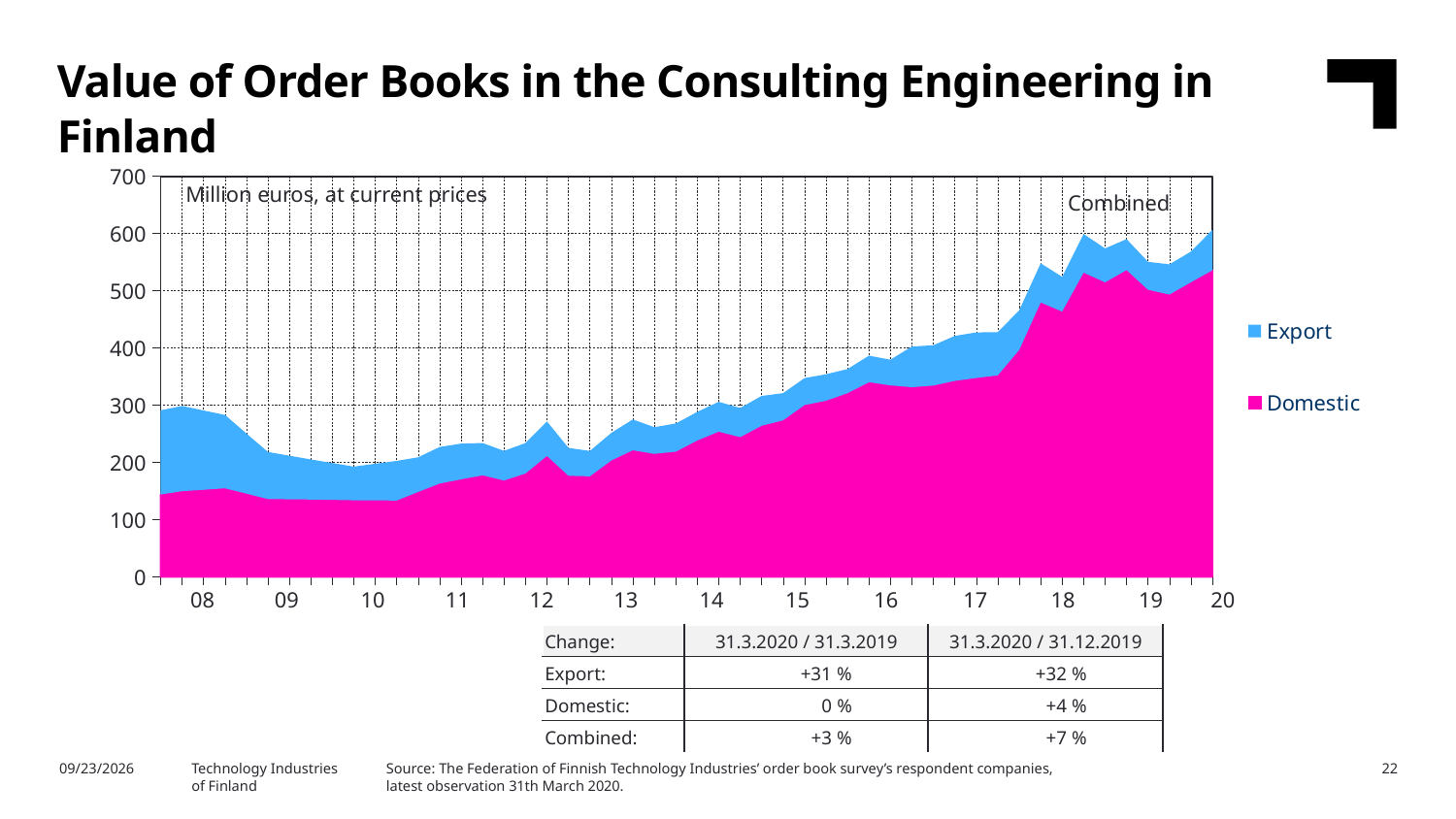
What is the highest value shown on the y axis? 700 How many year labels are shown on the x axis? 13 What unit is stated in the chart's annotation? Million euros, at current prices Which series is larger at the end of the series in 2020, Export or Domestic? Domestic Which two series are listed in the chart legend? Export and Domestic How many series does the legend list? 2 Is the Domestic value around 2010 greater or less than 200? less Is the combined value of order books at the end of the series (2020) greater or less than 500? greater Does the Domestic value generally rise or fall from 2008 to 2020? rise Is the Domestic value at the start of the series (2008) greater or less than 200? less What kind of chart is shown on the slide? Stacked area chart